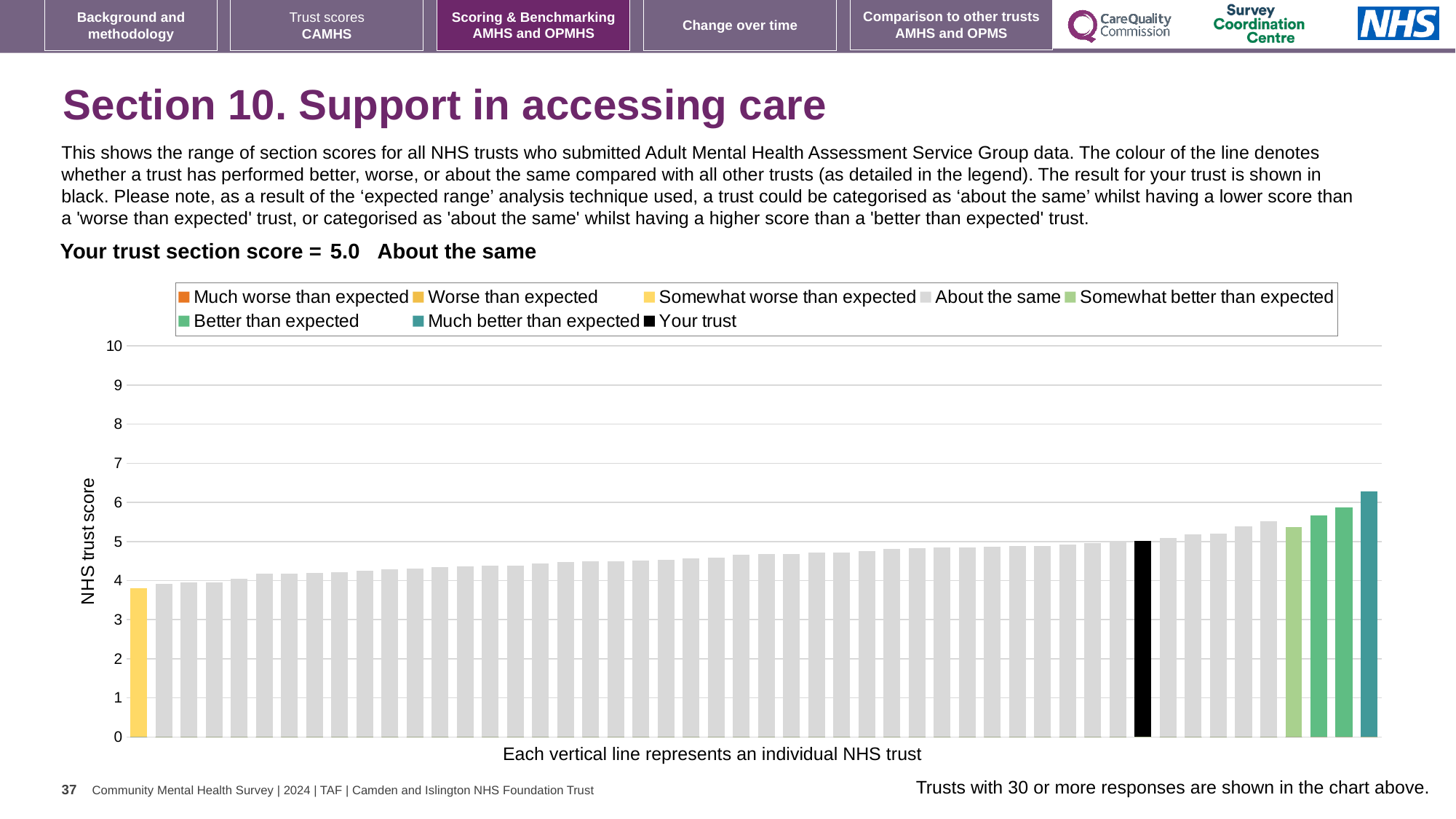
Is the value of the tallest bar greater or less than 6? greater How many entries does the chart legend list? 8 Do the bar values rise or fall from left to right across the chart? rise Which legend category does the tallest bar belong to? Much better than expected Is the value of the black bar (your trust) greater or less than 4? greater What is the section score for your trust? 5.0 Which legend category does your trust fall into? About the same What is the label on the vertical axis of the chart? NHS trust score How many bars are coloured as 'Much better than expected'? 1 What is the highest value shown on the vertical axis? 10 Is the value of the leftmost (yellow) bar greater or less than 4? less What kind of chart is shown on the slide? bar chart